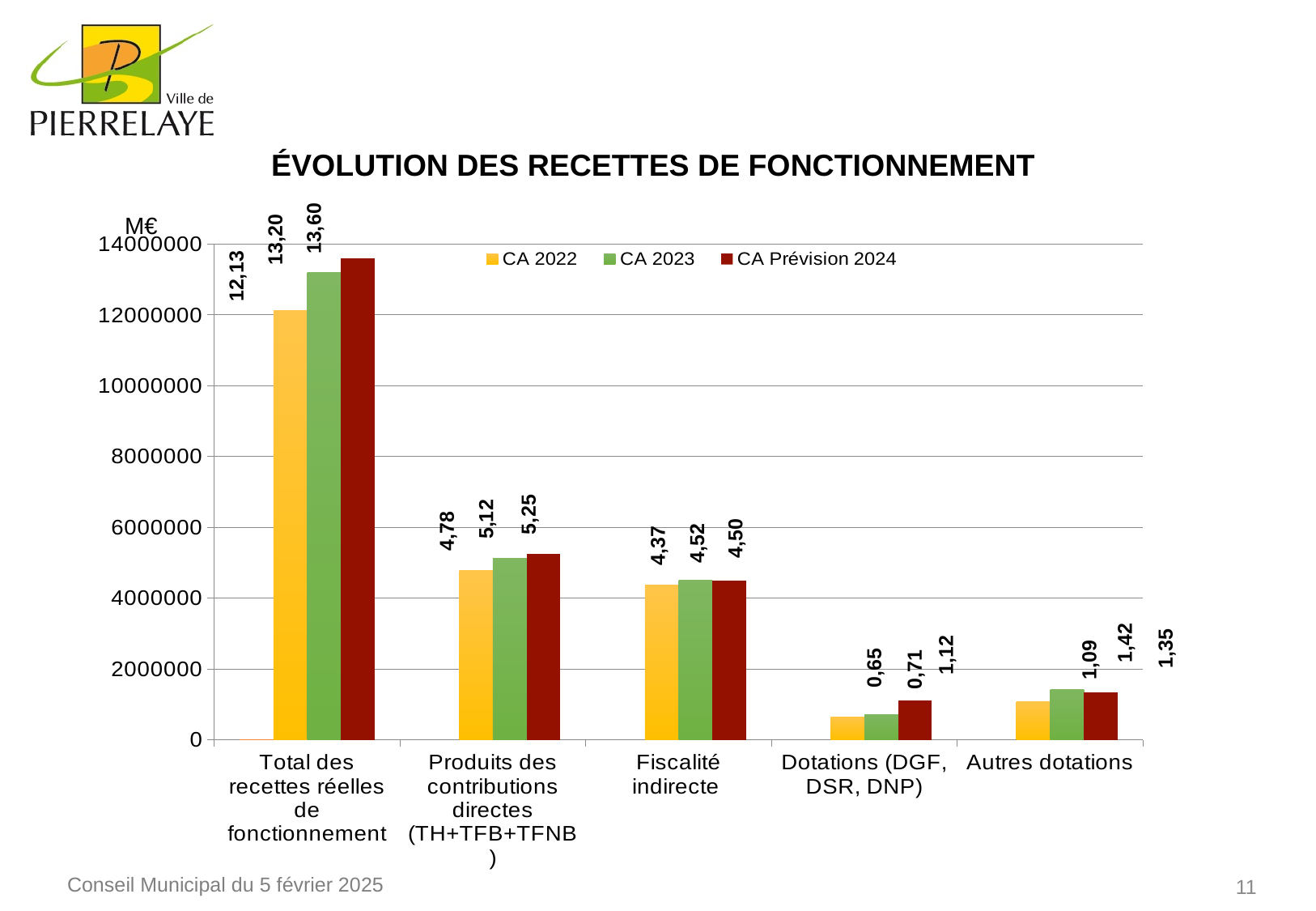
How many series does the legend list? 3 What is the CA 2022 value for Total des recettes réelles de fonctionnement? 12,13 What is the difference between the CA Prévision 2024 and CA 2022 values for Total des recettes réelles de fonctionnement? 1,47 What is the title of the chart? ÉVOLUTION DES RECETTES DE FONCTIONNEMENT Which category has the lowest CA 2022 value? Dotations (DGF, DSR, DNP) What type of chart is shown on the slide? bar chart How many categories are shown on the x axis? 5 What is the CA Prévision 2024 value for Dotations (DGF, DSR, DNP)? 1,12 Do the values for Produits des contributions directes (TH+TFB+TFNB) rise or fall from CA 2022 to CA Prévision 2024? rise What is the CA Prévision 2024 value for Produits des contributions directes (TH+TFB+TFNB)? 5,25 For Autres dotations, which is larger: the CA 2023 value or the CA Prévision 2024 value? CA 2023 What is the CA 2023 value for Fiscalité indirecte? 4,52